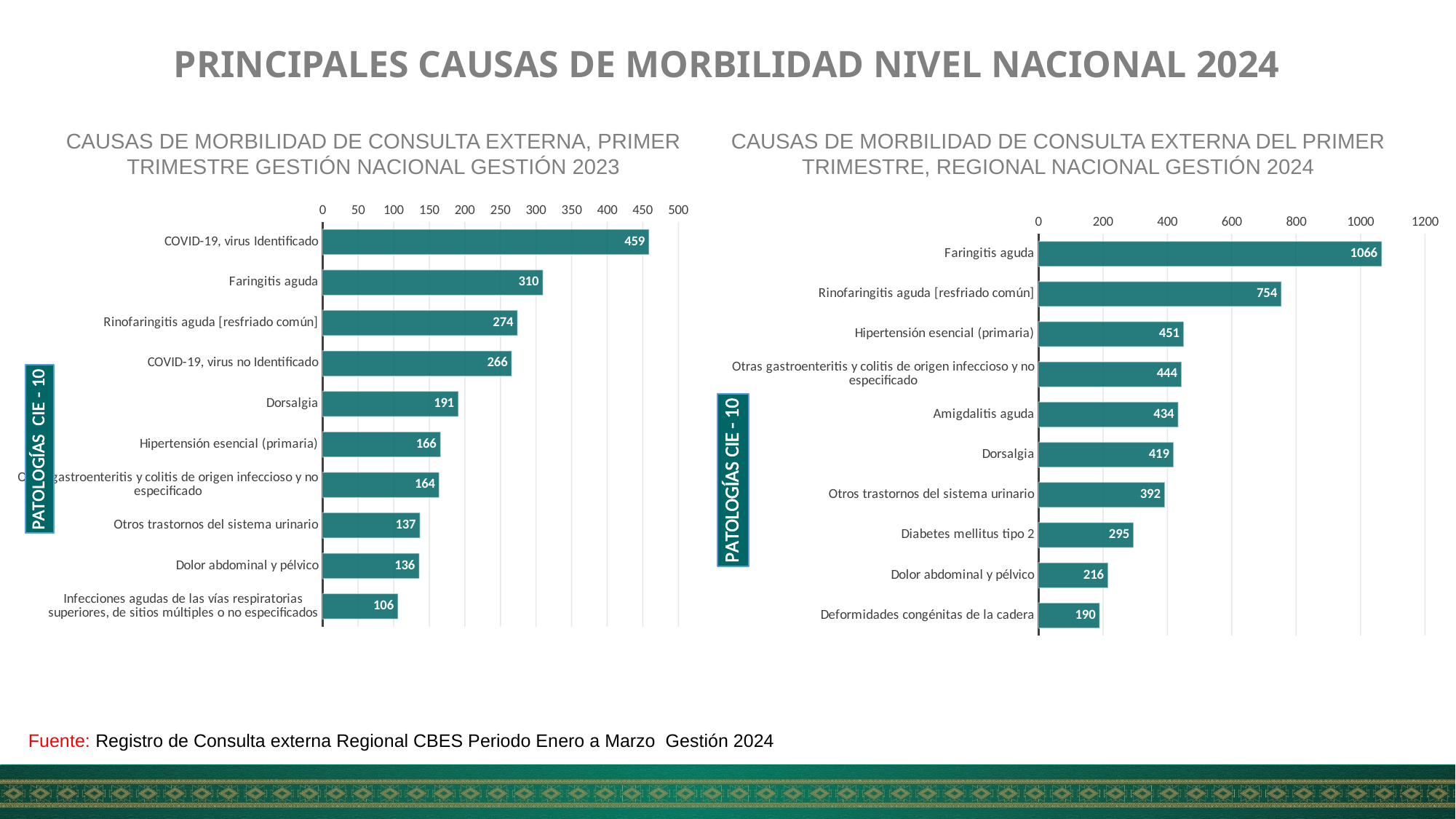
In the left chart (Gestión 2023), what is the value for Dolor abdominal y pélvico? 136 What kind of chart is the right chart (Gestión 2024)? bar chart How many categories are shown in the left chart (Gestión 2023)? 10 In the right chart (Gestión 2024), what is the difference between Faringitis aguda and Rinofaringitis aguda [resfriado común]? 312 In the right chart (Gestión 2024), is the value for Diabetes mellitus tipo 2 greater or less than 400? less In the left chart (Gestión 2023), which category has the highest value? COVID-19, virus Identificado In the right chart (Gestión 2024), which category has the lowest value? Deformidades congénitas de la cadera In the left chart (Gestión 2023), what is the value for Faringitis aguda? 310 In the left chart (Gestión 2023), which is larger: Dorsalgia or Hipertensión esencial (primaria)? Dorsalgia In the right chart (Gestión 2024), what is the difference between Dorsalgia and Otros trastornos del sistema urinario? 27 In the right chart (Gestión 2024), what is the value for Hipertensión esencial (primaria)? 451 What is the text on the vertical label beside each chart? PATOLOGÍAS CIE - 10